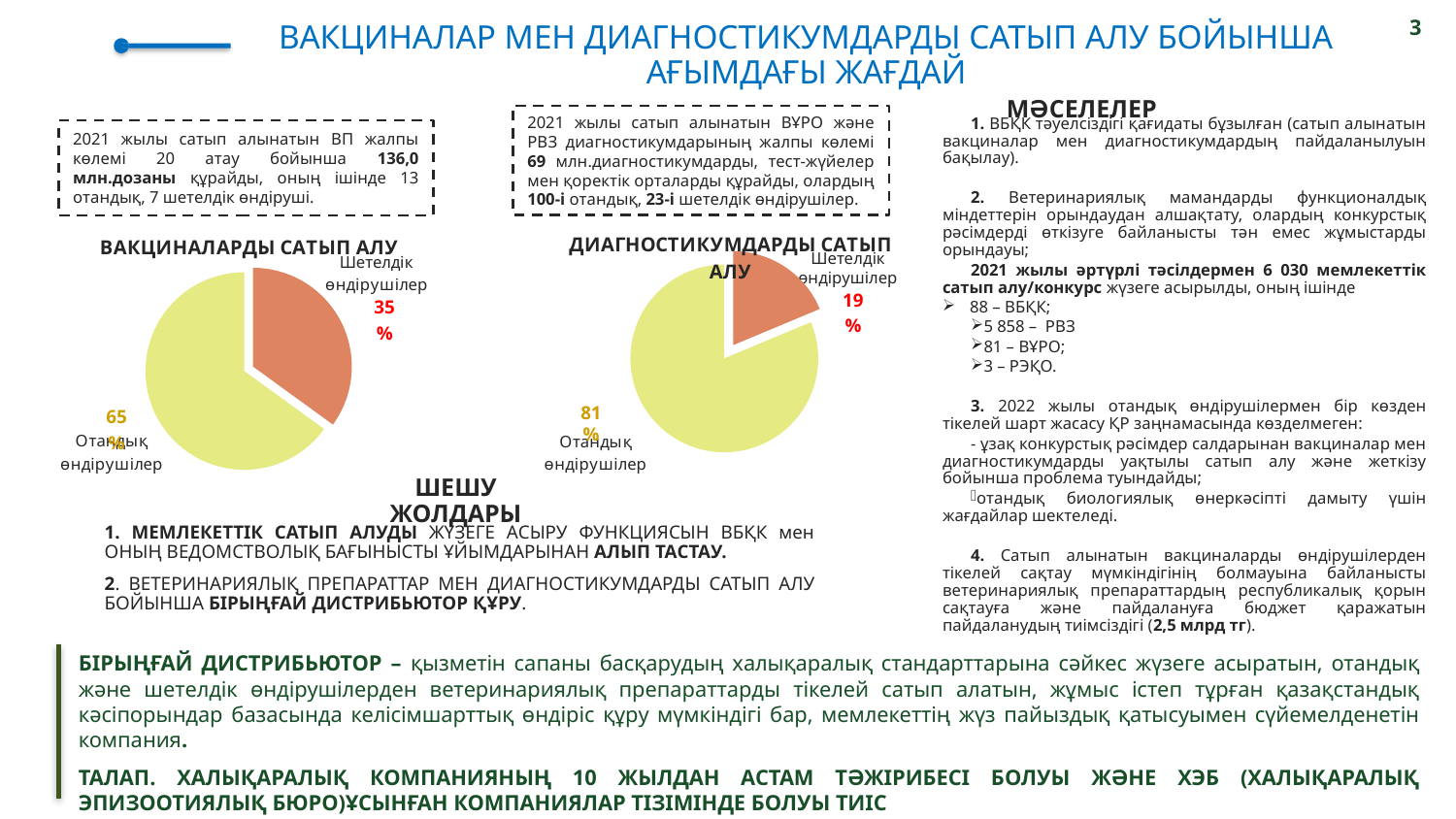
In the 'ДИАГНОСТИКУМДАРДЫ САТЫП АЛУ' pie chart, what is the difference in percentage points between Отандық өндірушілер and Шетелдік өндірушілер? 62 In the 'ВАКЦИНАЛАРДЫ САТЫП АЛУ' pie chart, what is the difference in percentage points between Отандық өндірушілер and Шетелдік өндірушілер? 30 In the 'ВАКЦИНАЛАРДЫ САТЫП АЛУ' pie chart, which slice is the largest? Отандық өндірушілер What type of chart is 'ДИАГНОСТИКУМДАРДЫ САТЫП АЛУ'? Pie chart In the 'ДИАГНОСТИКУМДАРДЫ САТЫП АЛУ' pie chart, what share is labelled for Отандық өндірушілер? 81% In the 'ДИАГНОСТИКУМДАРДЫ САТЫП АЛУ' pie chart, which slice is the smallest? Шетелдік өндірушілер In the 'ДИАГНОСТИКУМДАРДЫ САТЫП АЛУ' pie chart, what share is labelled for Шетелдік өндірушілер? 19% In the 'ВАКЦИНАЛАРДЫ САТЫП АЛУ' pie chart, what share is labelled for Шетелдік өндірушілер? 35% How many pie charts are shown on the slide? 2 How many slices does the 'ВАКЦИНАЛАРДЫ САТЫП АЛУ' pie chart have? 2 Which chart shows a larger share for Шетелдік өндірушілер: 'ВАКЦИНАЛАРДЫ САТЫП АЛУ' or 'ДИАГНОСТИКУМДАРДЫ САТЫП АЛУ'? ВАКЦИНАЛАРДЫ САТЫП АЛУ In the 'ВАКЦИНАЛАРДЫ САТЫП АЛУ' pie chart, what share is labelled for Отандық өндірушілер? 65%